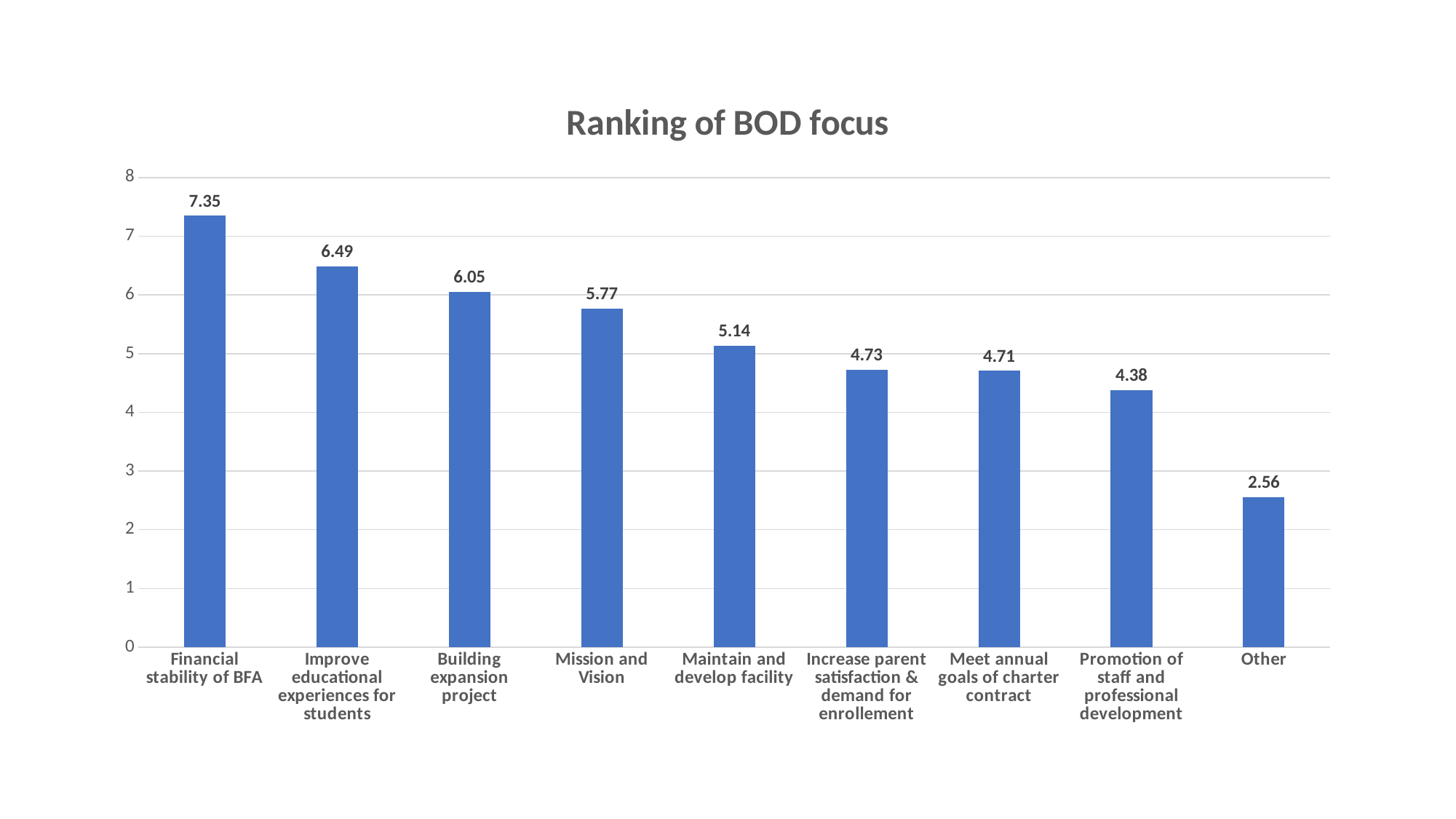
Which category has the lowest value? Other What is the value for Financial stability of BFA? 7.35 What is the difference between Improve educational experiences for students and Building expansion project? 0.44 What is the value for Mission and Vision? 5.77 Which is larger, Maintain and develop facility or Mission and Vision? Mission and Vision How many categories are shown in the chart? 9 What is the difference between Financial stability of BFA and Other? 4.79 What kind of chart is this? bar chart What is the title of the chart? Ranking of BOD focus Is the value for Increase parent satisfaction & demand for enrollment greater or less than 5? less What is the value for Promotion of staff and professional development? 4.38 Which category has the highest value? Financial stability of BFA